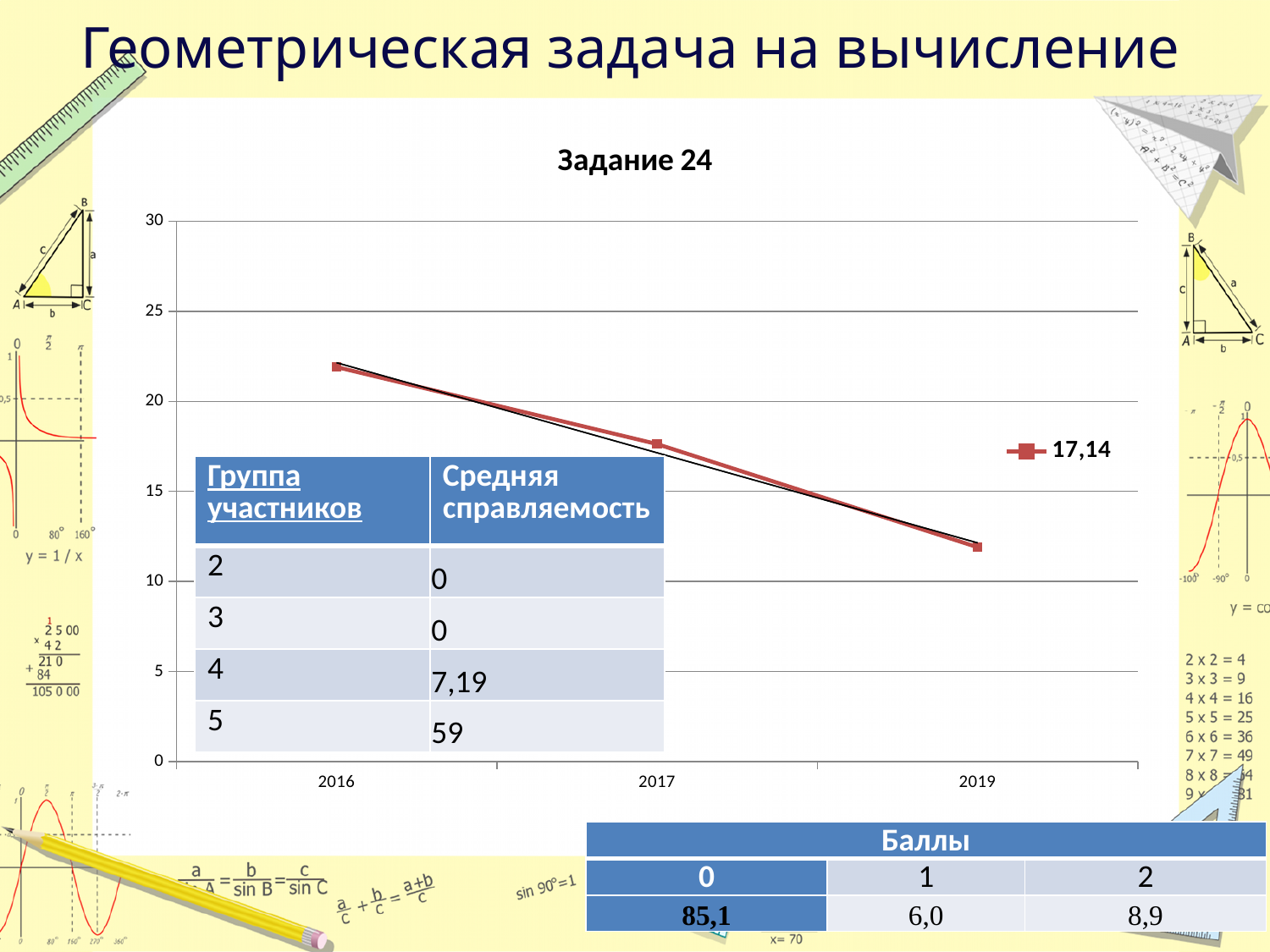
Which is larger, the value for 2016 or the value for 2019? 2016 Is the value for 2016 greater or less than 20? greater Do the values rise or fall from 2016 to 2019? fall What kind of chart is shown on the slide? line chart Is the value for 2019 greater or less than 15? less What is the title of the chart? Задание 24 Which year has the lowest value on the chart? 2019 How many data points are plotted on the line in the chart? 3 Which year has the highest value on the chart? 2016 How many series does the chart legend list? 1 What is the legend entry for the plotted series? 17,14 Is the value for 2017 greater or less than 20? less